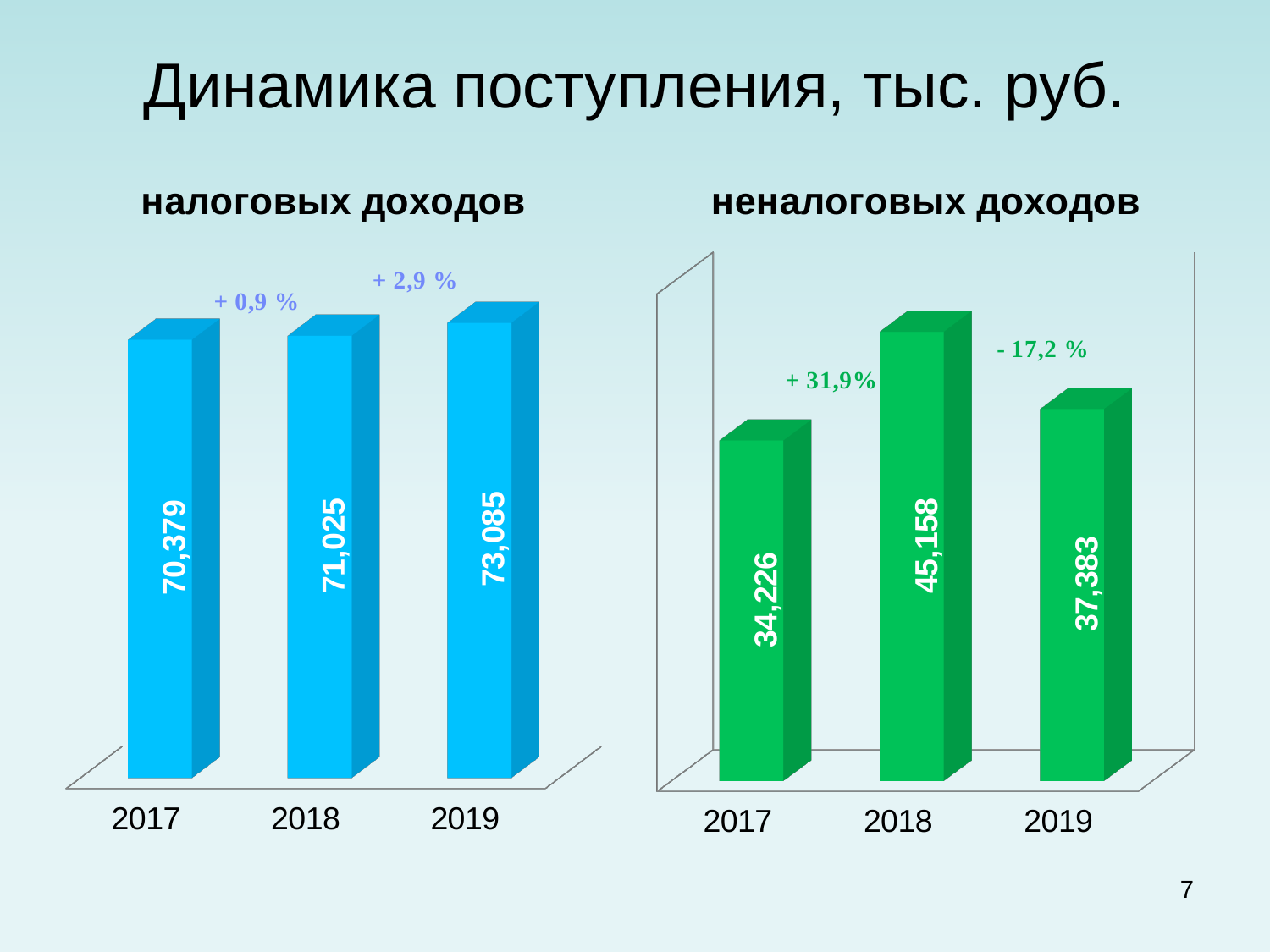
In the 'неналоговых доходов' chart, what is the value for 2018? 45,158 In the 'неналоговых доходов' chart, what is the difference between the 2018 and 2017 values? 10,932 What kind of chart is the 'неналоговых доходов' chart? Bar chart In the 'неналоговых доходов' chart, which year has the lowest value? 2017 In the 'неналоговых доходов' chart, which year has the highest value? 2018 In the 'налоговых доходов' chart, what is the value for 2017? 70,379 In the 'налоговых доходов' chart, what is the value for 2019? 73,085 In the 'налоговых доходов' chart, what is the difference between the 2019 and 2017 values? 2,706 How many bars are in the 'налоговых доходов' chart? 3 In the 'неналоговых доходов' chart, is the value for 2018 larger than the value for 2019? Yes In the 'налоговых доходов' chart, which year has the lowest value? 2017 In the 'неналоговых доходов' chart, what is the value for 2019? 37,383